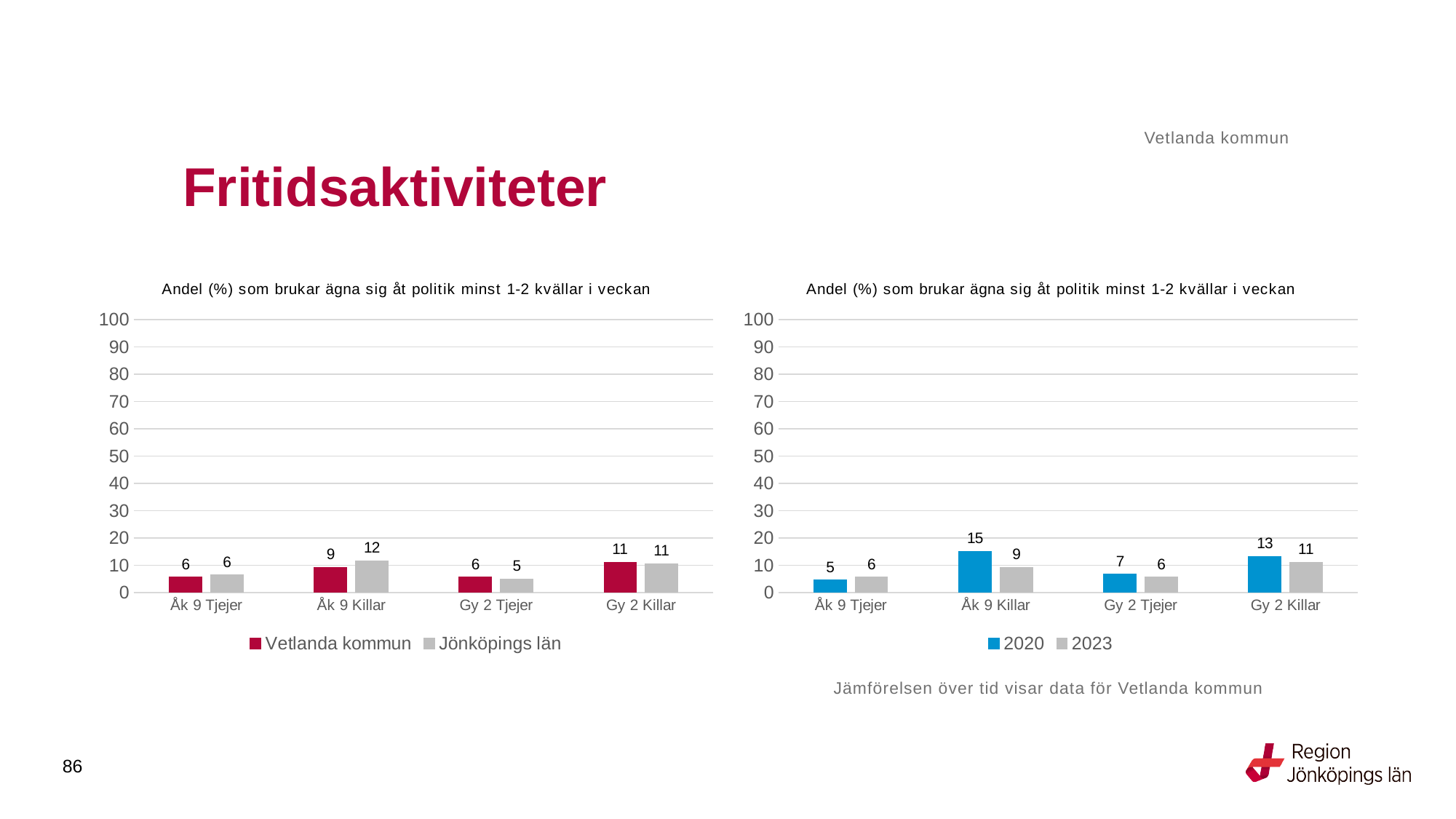
What kind of chart is the left chart? Bar chart In the left chart, what is the value for Jönköpings län for Åk 9 Killar? 12 How many categories are shown on the x axis of the left chart? 4 In the left chart, which category has the lowest Jönköpings län value? Gy 2 Tjejer In the right chart, which category has the highest 2020 value? Åk 9 Killar In the right chart, what is the difference between the 2020 and 2023 values for Åk 9 Killar? 6 In the right chart, which is larger for Gy 2 Killar: the 2020 value or the 2023 value? 2020 In the left chart, what is the value for Vetlanda kommun for Gy 2 Killar? 11 How many series does the legend of the right chart list? 2 In the left chart, what is the difference between the Jönköpings län and Vetlanda kommun values for Åk 9 Killar? 3 In the right chart, what is the 2020 value for Åk 9 Killar? 15 In the right chart, what is the 2023 value for Gy 2 Tjejer? 6